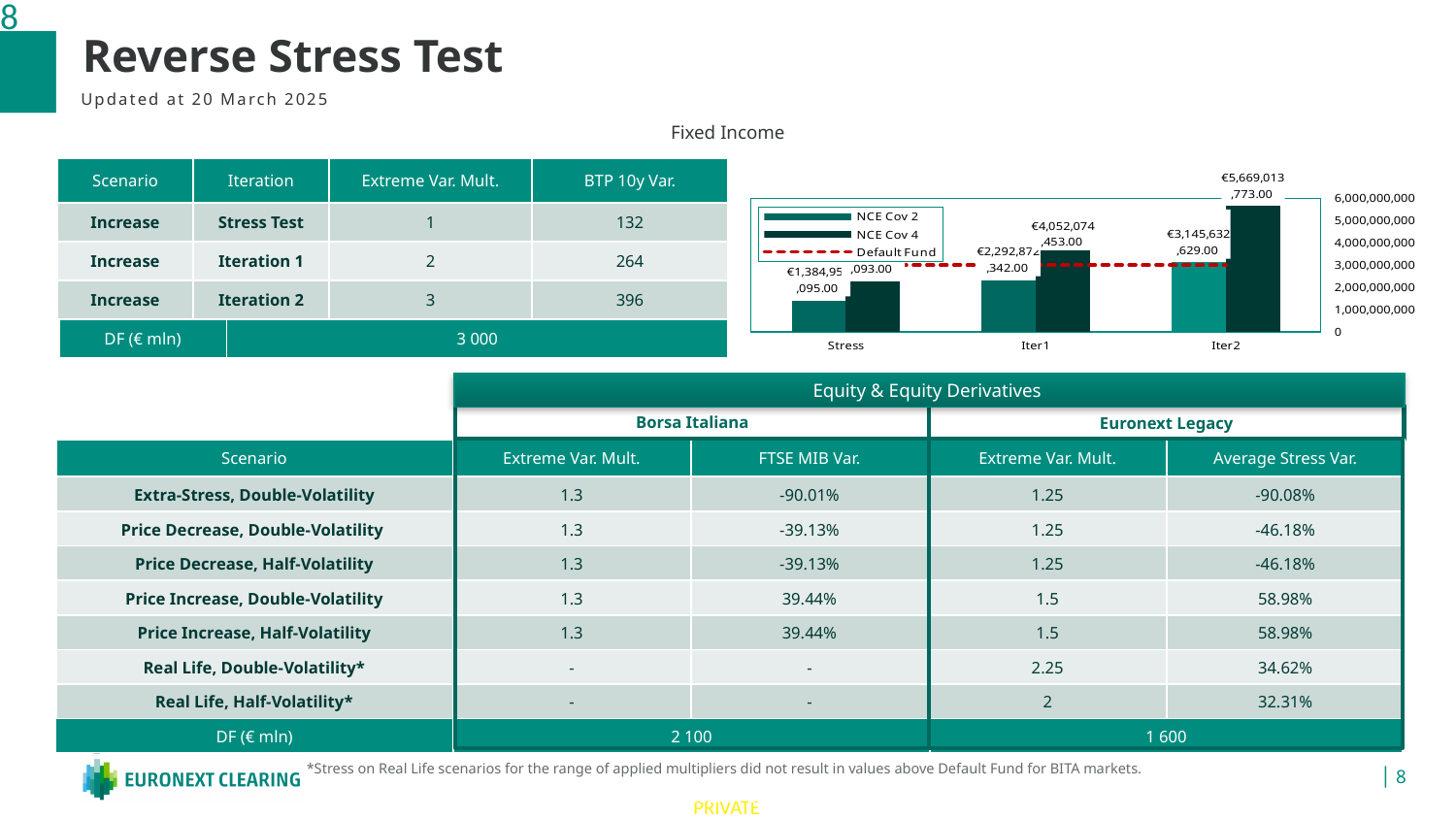
How many series does the chart legend list? 3 What is the value of NCE Cov 2 for Iter2? €3,145,632,629.00 Which category has the lowest NCE Cov 2 value? Stress How many categories are shown on the x axis of the chart? 3 What is the value of NCE Cov 4 for Iter1? €4,052,074,453.00 What is the difference between NCE Cov 4 and NCE Cov 2 for Iter2? €2,523,381,144.00 For Iter2, which is larger: NCE Cov 2 or NCE Cov 4? NCE Cov 4 What kind of chart is shown on the slide? bar chart Is the NCE Cov 2 value for Stress greater or less than 2,000,000,000? less Which category has the highest NCE Cov 4 value? Iter2 What is the value of NCE Cov 4 for Iter2? €5,669,013,773.00 Do the NCE Cov 4 values rise or fall from Stress to Iter2? rise